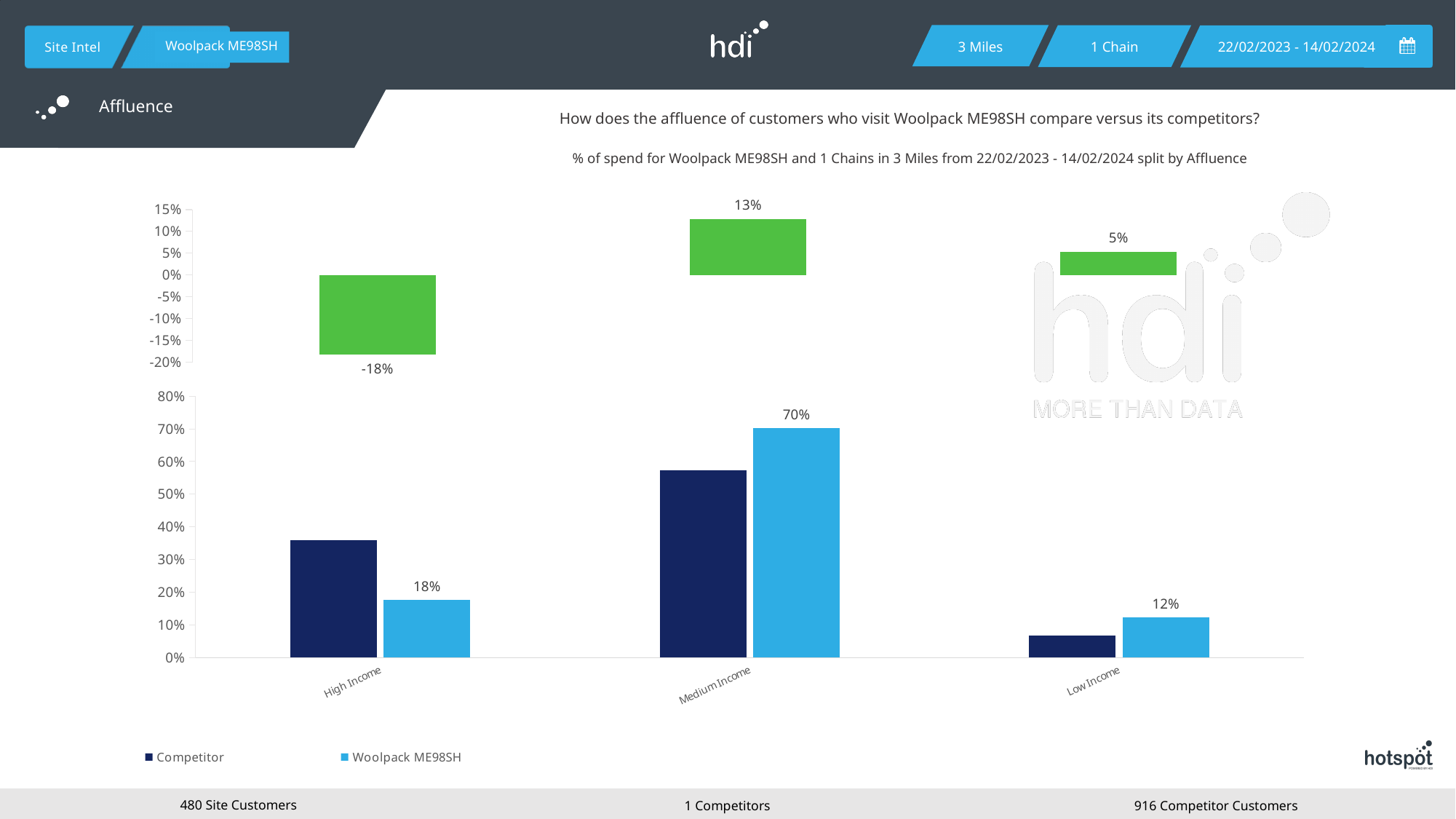
In the bottom chart, what is the value for Woolpack ME98SH in the High Income category? 18% In the top chart, which category has the lowest value? High Income In the bottom chart, what is the value for Woolpack ME98SH in the Low Income category? 12% In the bottom chart, which category has the highest Woolpack ME98SH value? Medium Income In the bottom chart, is the Competitor value for Low Income greater or less than 10%? less In the top chart, what is the value shown for the Medium Income category? 13% In the bottom chart, which is larger for Medium Income: Competitor or Woolpack ME98SH? Woolpack ME98SH In the top chart, what is the value shown for the High Income category? -18% In the bottom chart, is the Competitor value for High Income greater or less than 30%? greater In the bottom chart, what is the difference between the Woolpack ME98SH values for Medium Income and High Income? 52% How many series does the legend of the bottom chart list? 2 In the bottom chart, what is the value for Woolpack ME98SH in the Medium Income category? 70%